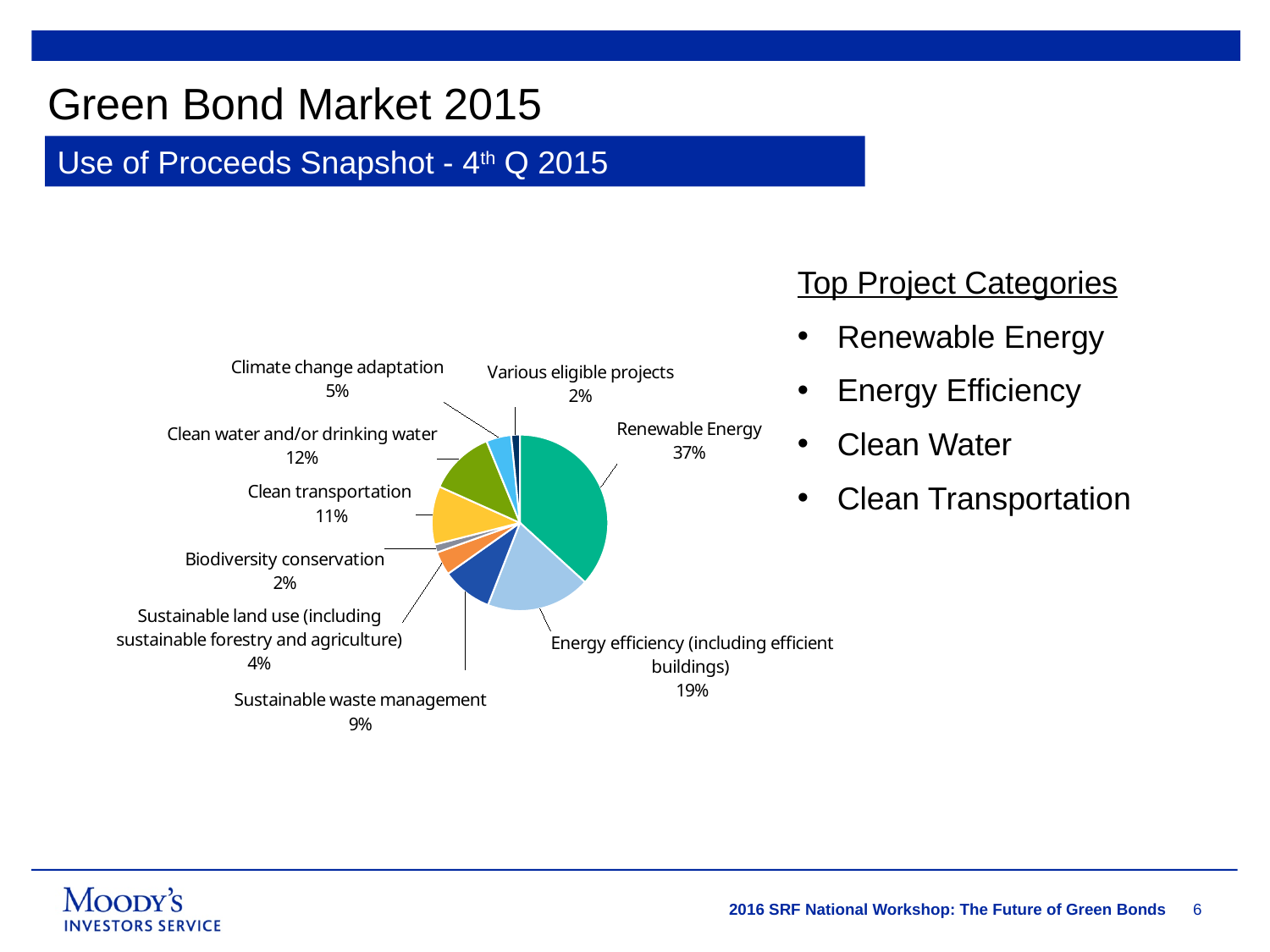
Which category has the largest share of the pie? Renewable Energy What is the difference in percentage points between Renewable Energy and Energy efficiency (including efficient buildings)? 18 What is the subtitle of the chart section on the slide? Use of Proceeds Snapshot - 4th Q 2015 Which is larger, Clean transportation or Clean water and/or drinking water? Clean water and/or drinking water How many categories are shown in the pie chart? 9 What percentage is shown for Energy efficiency (including efficient buildings)? 19% What percentage is shown for Clean water and/or drinking water? 12% What percentage is shown for Climate change adaptation? 5% What percentage is shown for Sustainable waste management? 9% What share of proceeds goes to Renewable Energy? 37% What is the combined share of Biodiversity conservation and Various eligible projects? 4% What kind of chart is shown on the slide? Pie chart